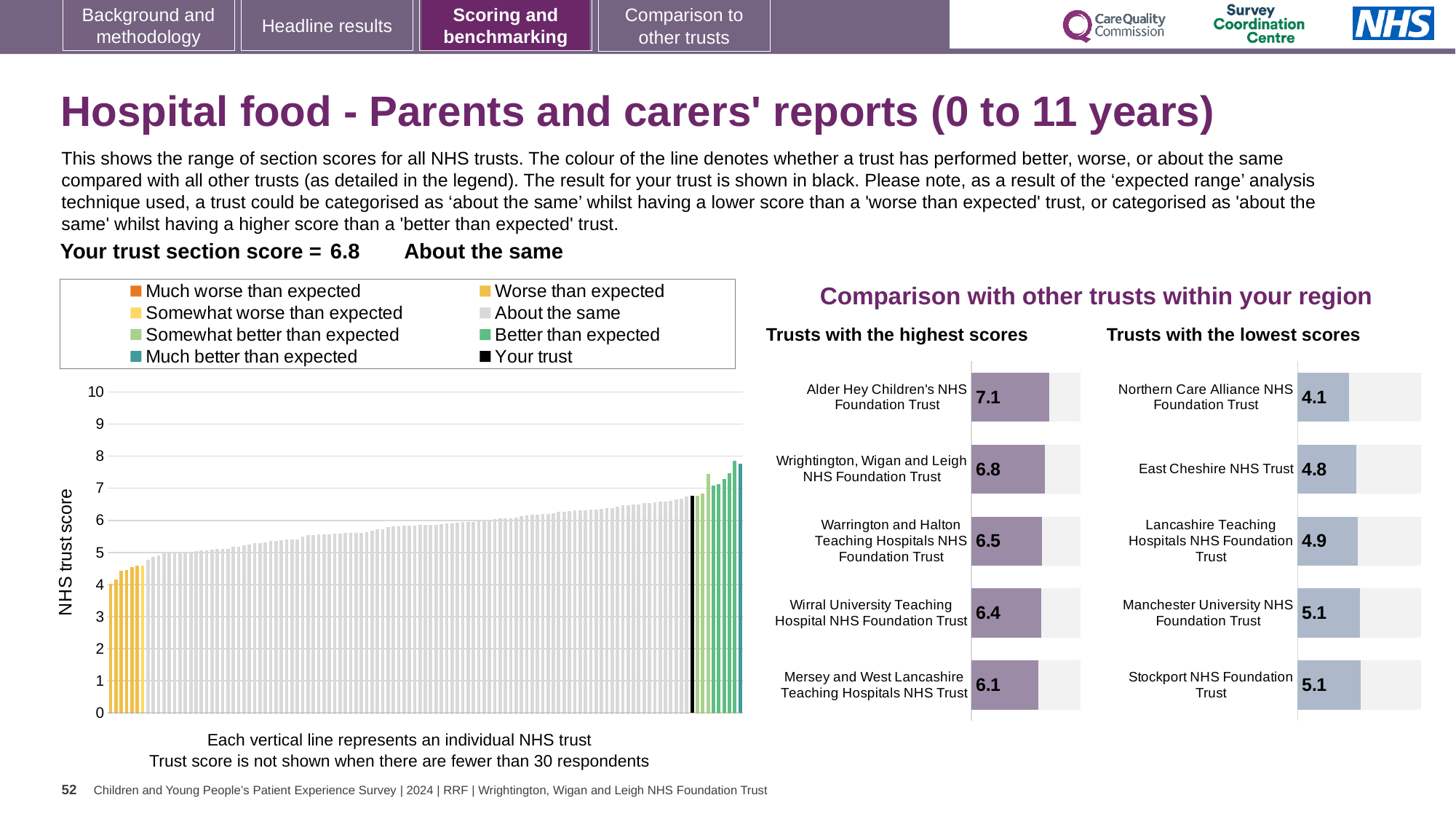
In the 'Trusts with the lowest scores' chart, which trust has the lowest score? Northern Care Alliance NHS Foundation Trust How many entries does the legend of the NHS trust score chart on the left list? 8 In the NHS trust score chart on the left, is the value of the lowest bar greater or less than 5? less In the NHS trust score chart on the left, what colour is the bar for 'Your trust' according to the legend? Black In the 'Trusts with the highest scores' chart, what is the difference between the scores of Alder Hey Children's NHS Foundation Trust and Mersey and West Lancashire Teaching Hospitals NHS Trust? 1.0 In the 'Trusts with the lowest scores' chart, what is the score for Northern Care Alliance NHS Foundation Trust? 4.1 In the 'Trusts with the highest scores' chart, what is the score for Alder Hey Children's NHS Foundation Trust? 7.1 In the 'Trusts with the lowest scores' chart, which has the higher score: East Cheshire NHS Trust or Lancashire Teaching Hospitals NHS Foundation Trust? Lancashire Teaching Hospitals NHS Foundation Trust In the NHS trust score chart on the left, do the bar values rise or fall from left to right? Rise How many trusts are shown in the 'Trusts with the highest scores' chart? 5 What kind of chart is the NHS trust score chart on the left of the slide? Bar chart In the 'Trusts with the highest scores' chart, which trust has the highest score? Alder Hey Children's NHS Foundation Trust